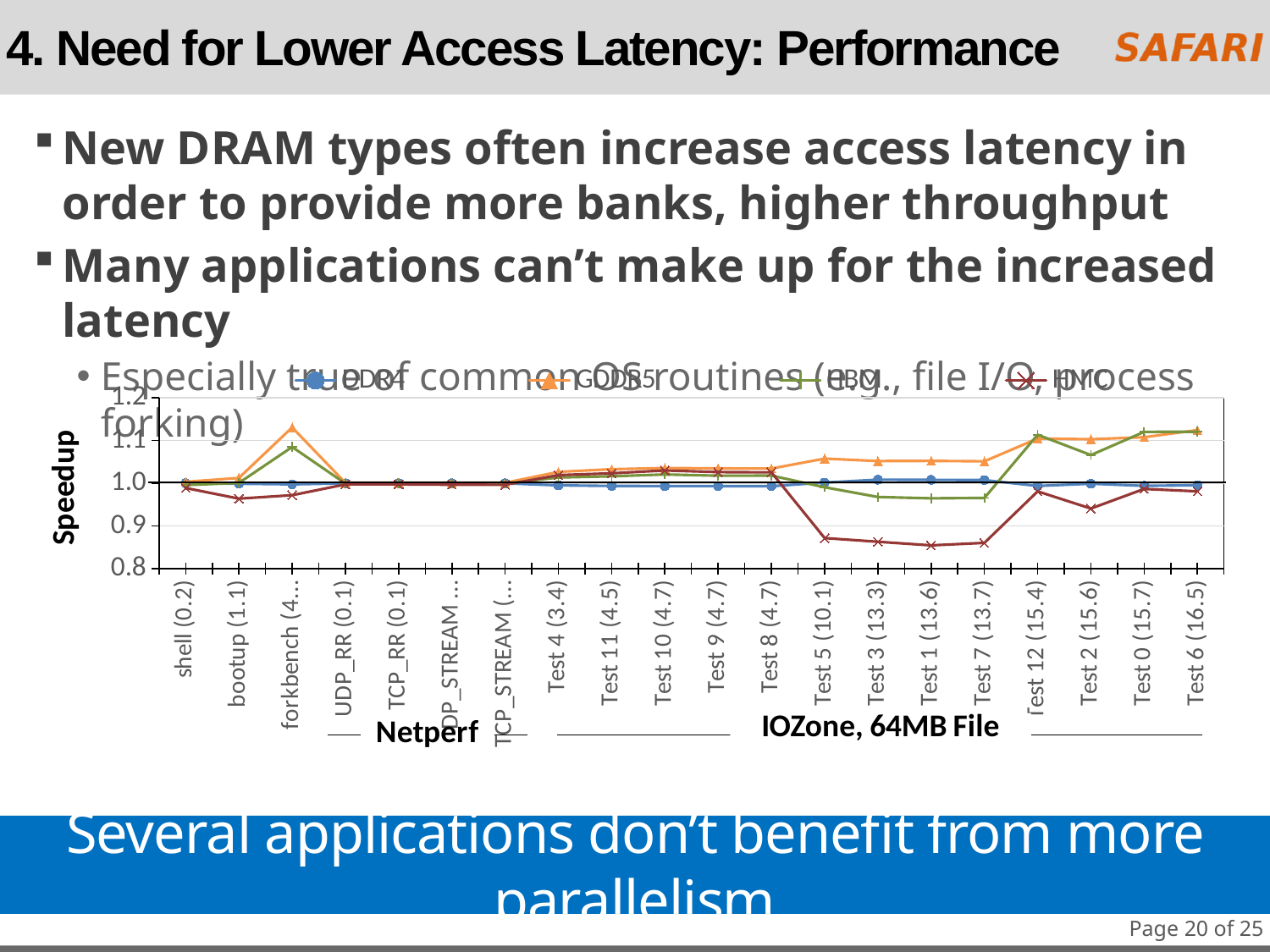
What is the title of the chart's y axis? Speedup Which series is lowest at Test 1 (13.6)? HMC Which group label is shown under the right-hand set of categories on the x axis? IOZone, 64MB File How many categories are plotted along the x axis of the chart? 20 Is the GDDR5 value for Test 6 (16.5) greater or less than 1.1? greater Which series is highest at forkbench? GDDR5 What kind of chart is shown on the slide? line chart Is the GDDR5 value for forkbench greater or less than 1.1? greater How many series does the chart's legend list? 4